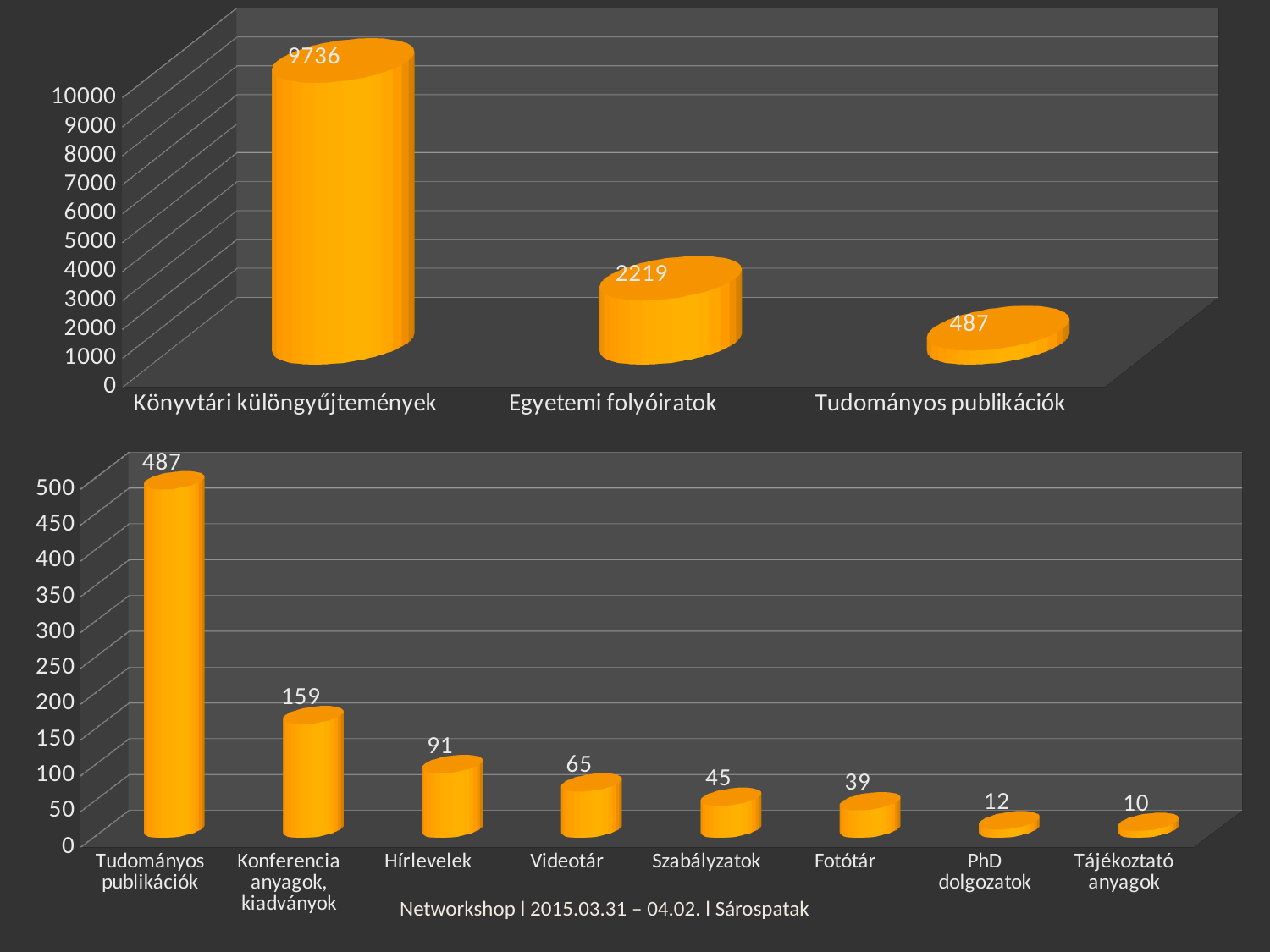
In the bottom chart, which is larger, Videotár or Szabályzatok? Videotár What type of chart is the bottom chart? Bar chart In the top chart, which category has the highest value? Könyvtári különgyűjtemények How many categories are shown in the top chart? 3 In the top chart, what is the value for Egyetemi folyóiratok? 2219 How many categories are shown in the bottom chart? 8 In the bottom chart, which category has the lowest value? Tájékoztató anyagok In the bottom chart, what is the value for PhD dolgozatok? 12 In the bottom chart, what is the difference between Konferencia anyagok, kiadványok and Fotótár? 120 In the bottom chart, what is the value for Hírlevelek? 91 In the top chart, what is the difference between Könyvtári különgyűjtemények and Egyetemi folyóiratok? 7517 In the bottom chart, do the values rise or fall from left to right? Fall